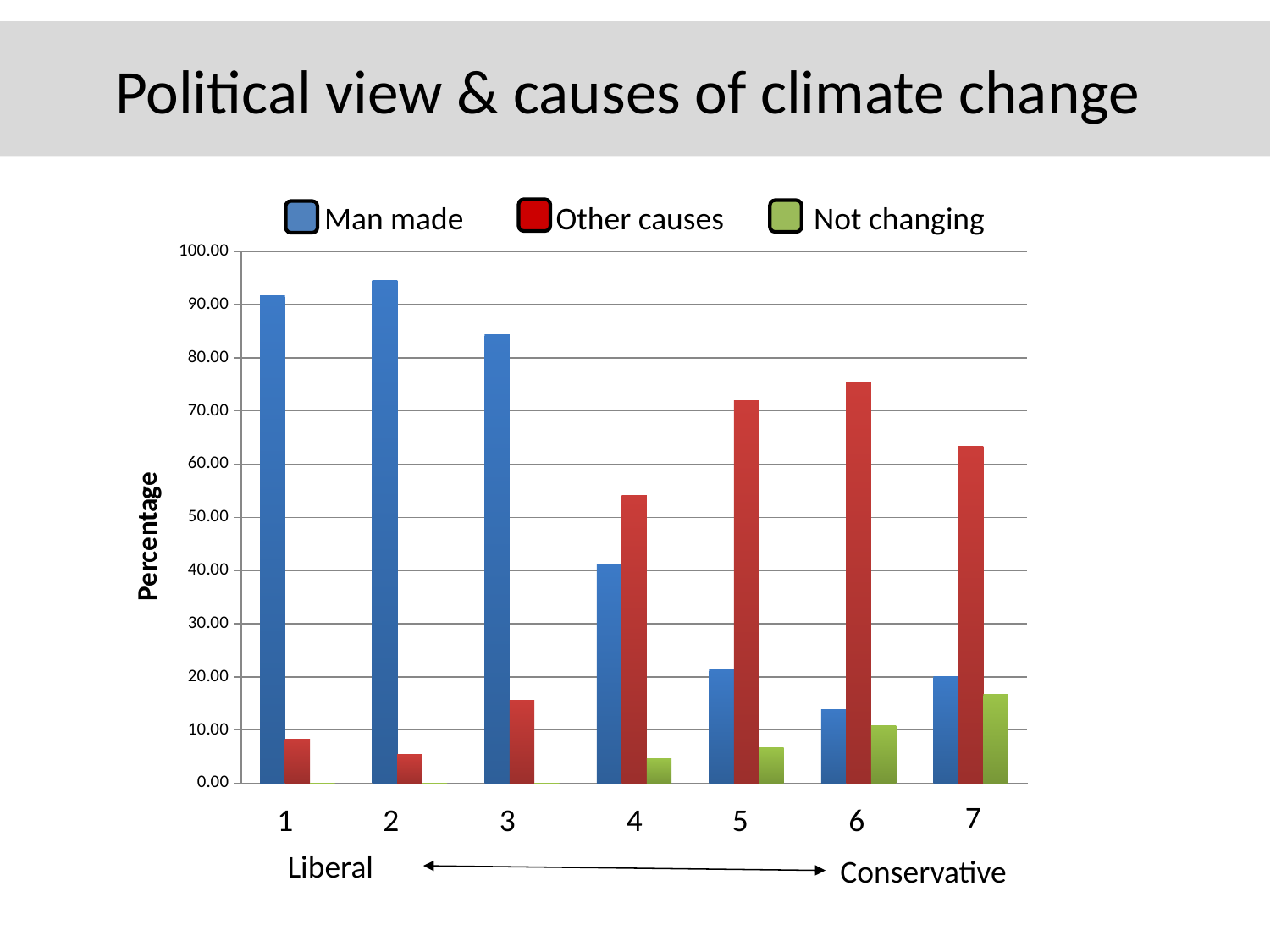
For which category is the Not changing bar highest? 7 Is the Not changing value for category 7 greater or less than 10.00? greater How many political view categories are shown on the x axis? 7 For which category is the Man made bar highest? 2 Is the Other causes value for category 5 greater or less than 60.00? greater For which category is the Man made bar lowest? 6 Is the Man made value for category 4 greater or less than 50.00? less How many series does the legend list? 3 For category 4, which is larger: Man made or Other causes? Other causes Do the Man made values generally rise or fall from category 1 (Liberal) to category 7 (Conservative)? fall What kind of chart is shown on the slide? bar chart For which category is the Other causes bar highest? 6